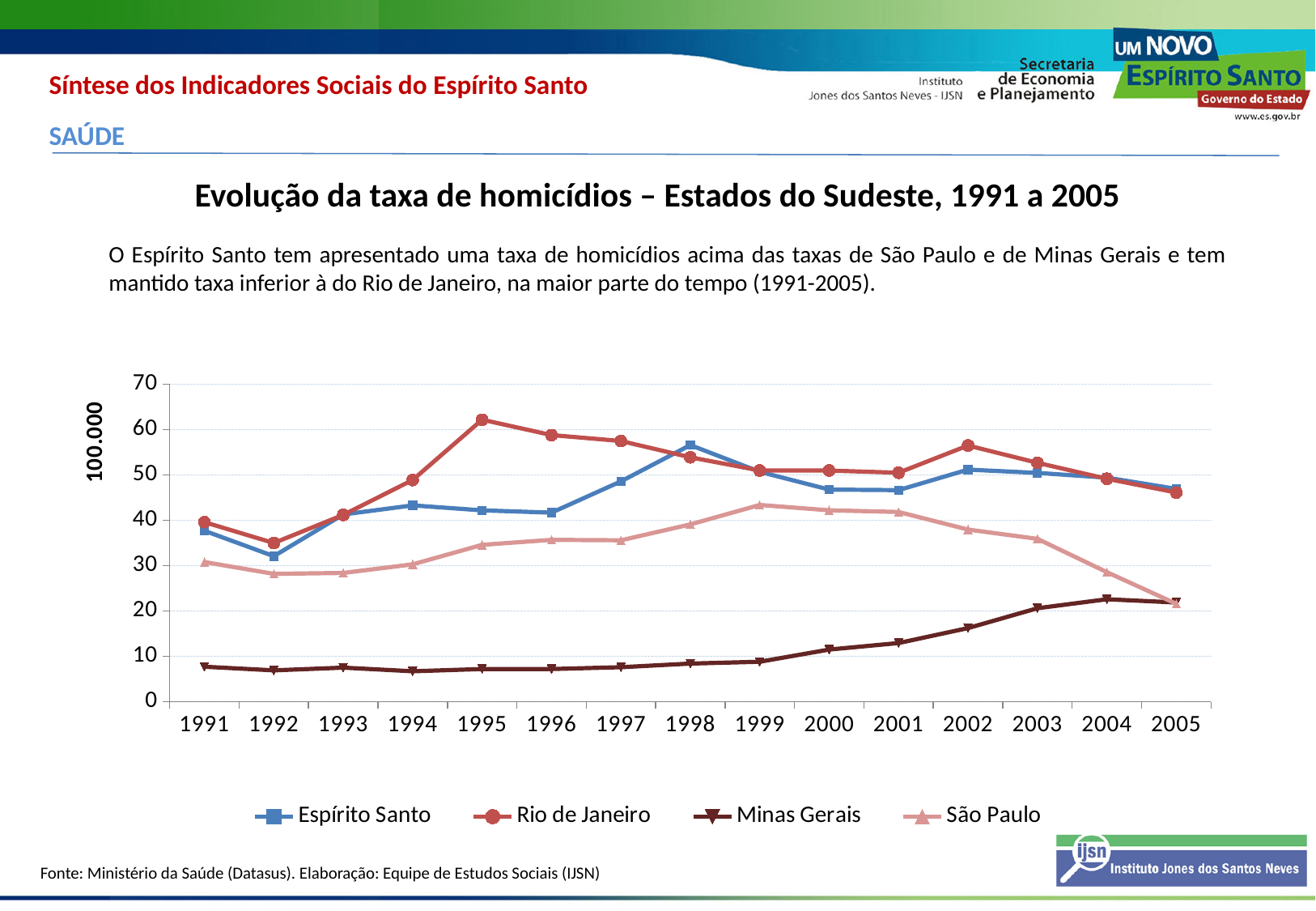
Is the value for São Paulo in 2005 greater or less than 30? less What kind of chart is shown on the slide? line chart In which year does Espírito Santo have its lowest value? 1992 How many years are plotted along the x axis? 15 What is the title of the chart? Evolução da taxa de homicídios – Estados do Sudeste, 1991 a 2005 In which year does Rio de Janeiro reach its highest value? 1995 Which state has the highest homicide rate in 1995? Rio de Janeiro Which state has the lowest homicide rate in 1991? Minas Gerais Is the value for Minas Gerais in 1991 greater or less than 10? less Does the Minas Gerais line rise or fall from 1991 to 2005? rises How many series does the legend list? 4 Is the value for Rio de Janeiro in 1995 greater or less than 60? greater